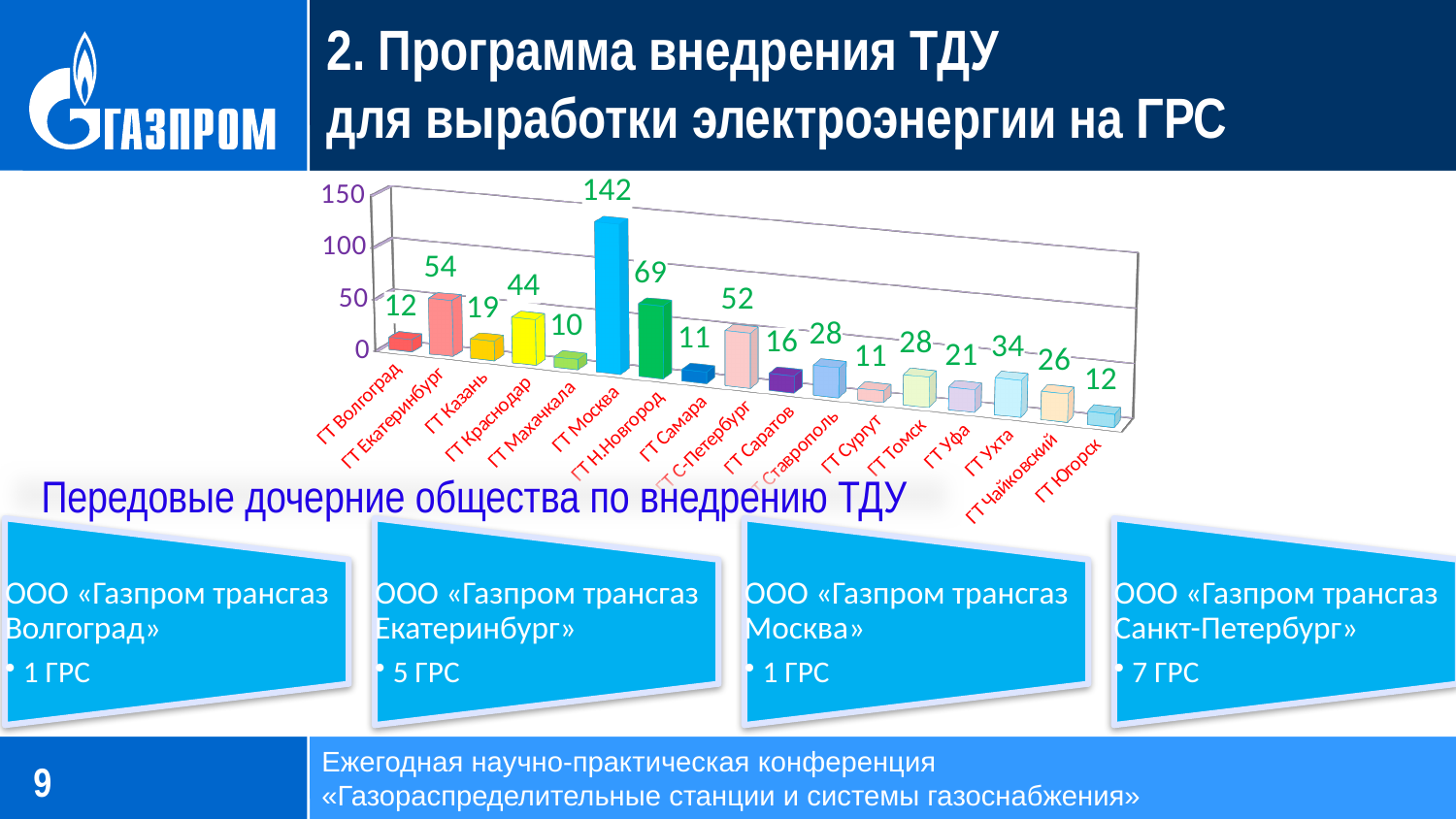
Which category has the lowest value? ГТ Махачкала Which category has the highest value? ГТ Москва Is the value for ГТ Н.Новгород greater or less than 50? greater What type of chart is shown on the slide? bar chart What is the value for ГТ Ухта? 34 Which is larger, the value for ГТ Краснодар or the value for ГТ Казань? ГТ Краснодар How many categories are shown on the x axis of the chart? 17 What is the value for ГТ С-Петербург? 52 What is the difference between the values for ГТ Москва and ГТ Н.Новгород? 73 What is the value for ГТ Екатеринбург? 54 What is the difference between the values for ГТ Екатеринбург and ГТ Волгоград? 42 What is the value for ГТ Москва? 142